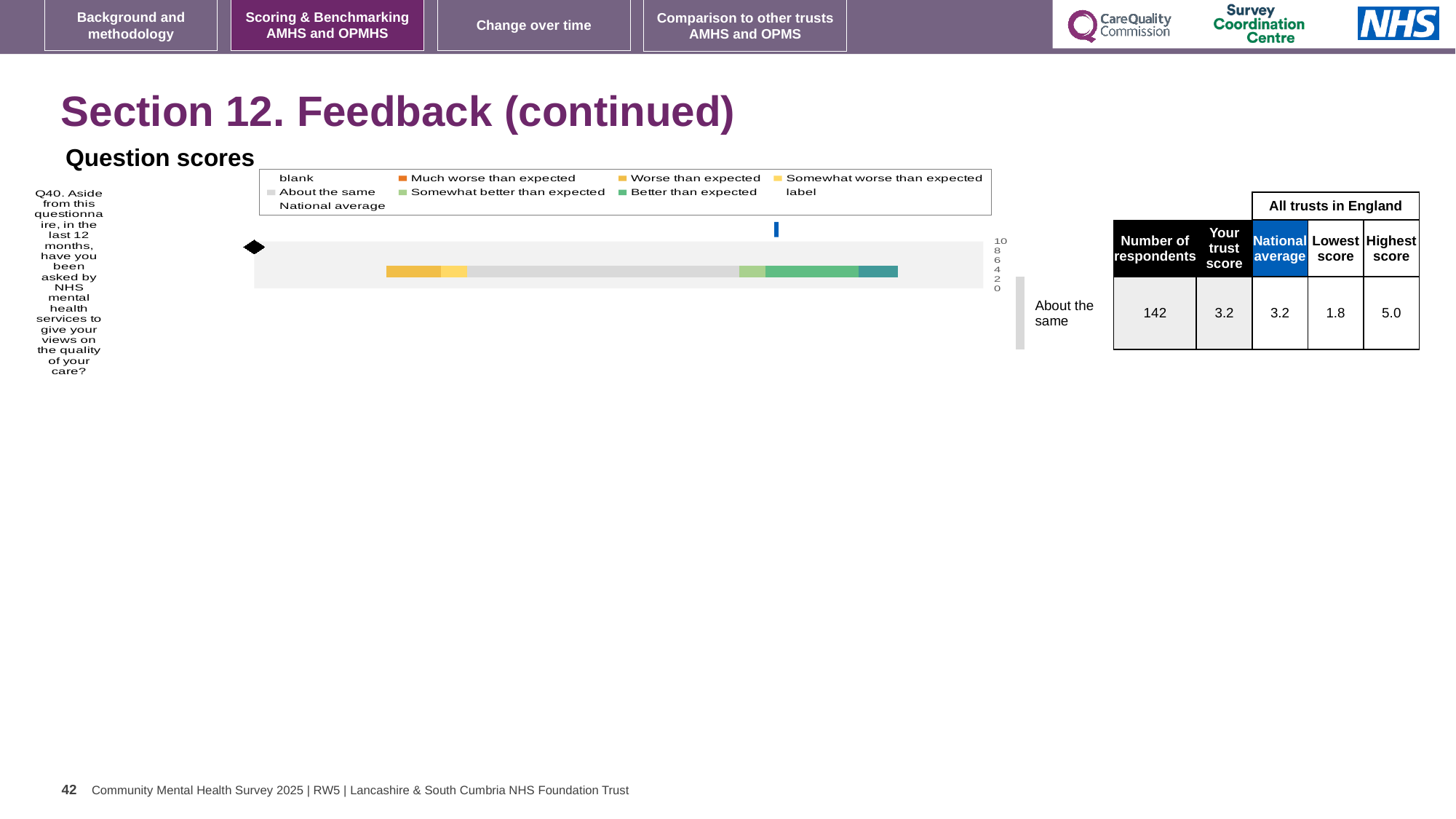
In the table beside the Question scores chart, what is the highest score among all trusts in England for Q40? 5.0 In the table beside the Question scores chart, what is the number of respondents for Q40? 142 In the table beside the Question scores chart, what is the trust's score for Q40? 3.2 In the Question scores chart legend, which entry is shown in orange? Much worse than expected What rating label is shown to the right of the Q40 bar in the Question scores chart? About the same In the table beside the Question scores chart, is the trust's score for Q40 higher or lower than the lowest score in England? higher Which question is plotted in the Question scores chart? Q40. Aside from this questionnaire, in the last 12 months, have you been asked by NHS mental health services to give your views on the quality of your care? In the table beside the Question scores chart, what is the lowest score among all trusts in England for Q40? 1.8 What kind of chart is shown under 'Question scores'? bar chart In the table beside the Question scores chart, what is the national average for Q40? 3.2 How many questions (categories) are plotted in the Question scores chart? 1 In the table beside the Question scores chart, what is the difference between the highest score and the lowest score for Q40? 3.2